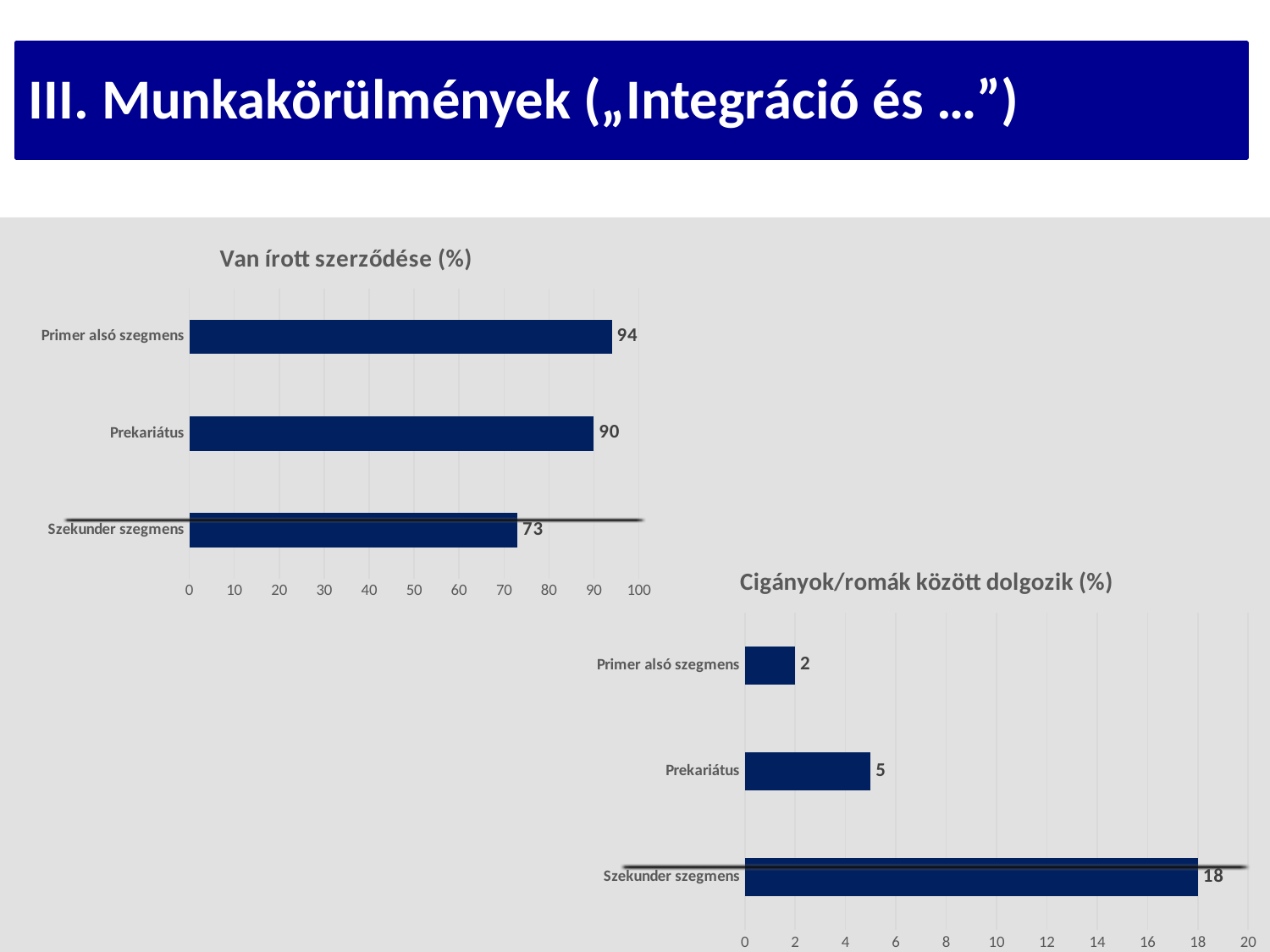
In the chart titled "Cigányok/romák között dolgozik (%)", what is the difference between Szekunder szegmens and Primer alsó szegmens? 16 In the chart titled "Cigányok/romák között dolgozik (%)", which category has the highest value? Szekunder szegmens In the chart titled "Van írott szerződése (%)", what is the value for Primer alsó szegmens? 94 What is the title of the chart in the upper left of the slide? Van írott szerződése (%) In the chart titled "Van írott szerződése (%)", what is the value for Szekunder szegmens? 73 In the chart titled "Van írott szerződése (%)", how many categories are shown? 3 In the chart titled "Cigányok/romák között dolgozik (%)", what is the value for Prekariátus? 5 In the chart titled "Cigányok/romák között dolgozik (%)", what is the value for Szekunder szegmens? 18 What kind of chart is the chart titled "Cigányok/romák között dolgozik (%)"? Bar chart In the chart titled "Van írott szerződése (%)", which category has the lowest value? Szekunder szegmens In the chart titled "Cigányok/romák között dolgozik (%)", which is larger: Primer alsó szegmens or Prekariátus? Prekariátus In the chart titled "Van írott szerződése (%)", what is the difference between Primer alsó szegmens and Prekariátus? 4